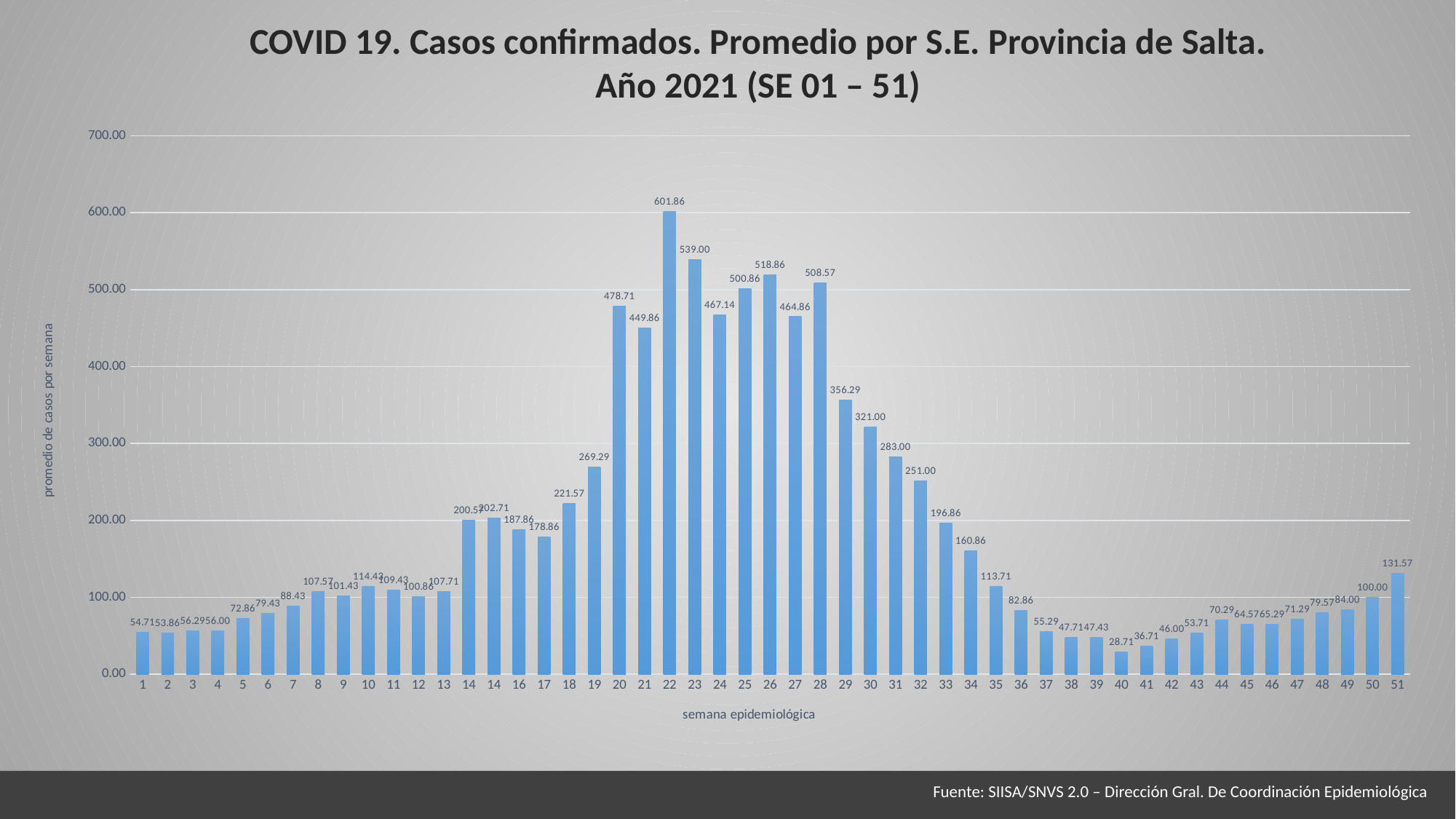
Is the value for week 19 greater or less than 300? less Which has a higher value, week 20 or week 21? Week 20 Which epidemiological week has the lowest average of confirmed cases? 40 What is the difference between the values for week 22 and week 23? 62.86 What is the label of the vertical axis? promedio de casos por semana What is the value shown for epidemiological week 51? 131.57 Do the values rise or fall from week 28 to week 35? Fall What is the value shown for epidemiological week 40? 28.71 Which epidemiological week has the highest average of confirmed cases? 22 What is the average number of confirmed cases for epidemiological week 22? 601.86 What type of chart is shown on the slide? Bar chart What is the difference between the values for week 50 and week 40? 71.29